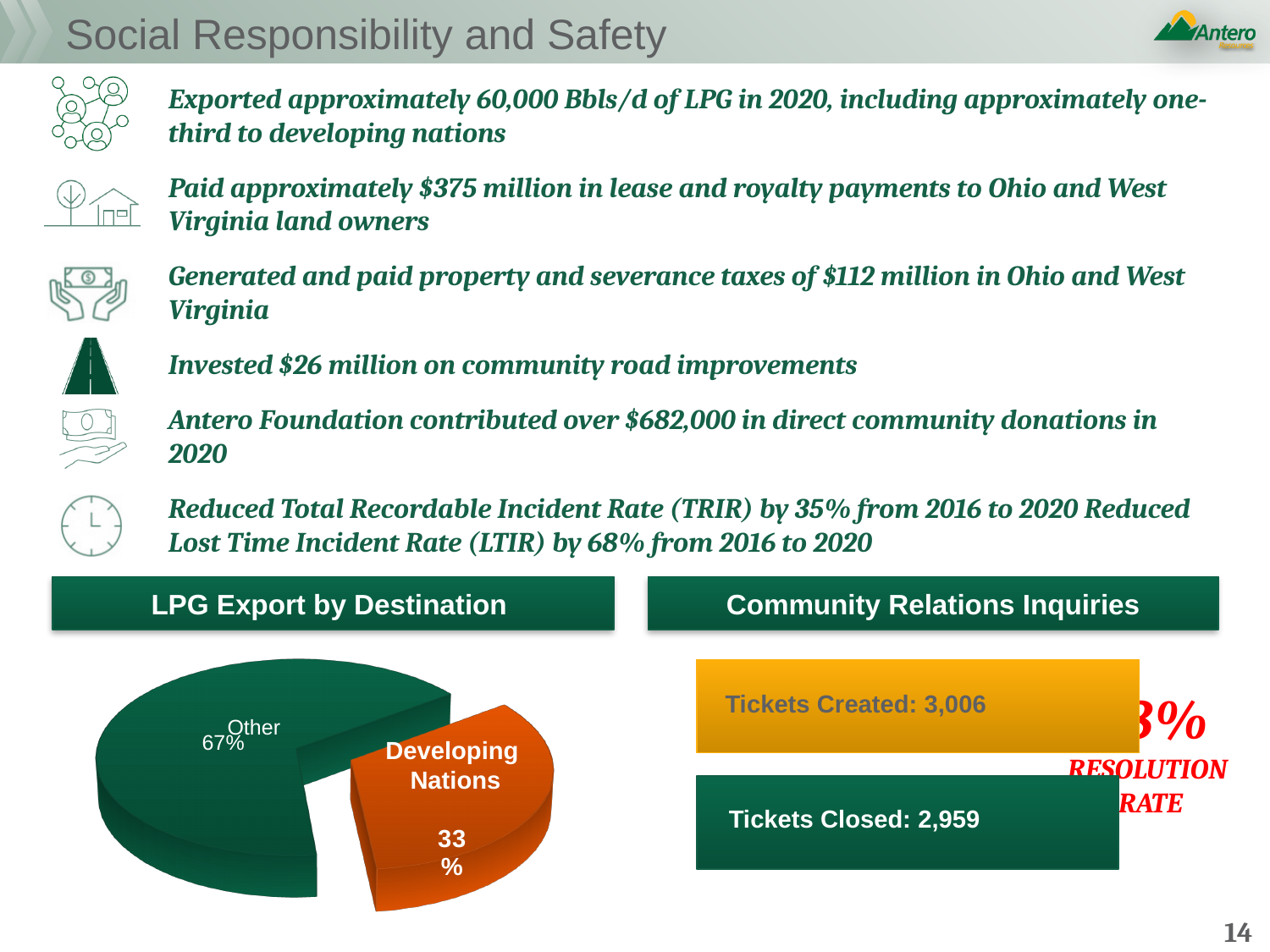
In the 'LPG Export by Destination' chart, which destination category has the smallest share? Developing Nations In the 'LPG Export by Destination' chart, what colour is the Developing Nations slice? orange In the 'LPG Export by Destination' chart, what share of LPG exports goes to Developing Nations? 33% In the 'Community Relations Inquiries' chart, how many tickets were created? 3,006 In the 'LPG Export by Destination' chart, which slice is larger: Other or Developing Nations? Other In the 'LPG Export by Destination' chart, how many slices does the pie have? 2 In the 'LPG Export by Destination' chart, which destination category has the largest share? Other In the 'LPG Export by Destination' chart, what is the difference in percentage points between the Other share and the Developing Nations share? 34 percentage points In the 'Community Relations Inquiries' chart, what is the difference between tickets created and tickets closed? 47 In the 'LPG Export by Destination' chart, what share of LPG exports goes to Other destinations? 67% What kind of chart is the 'LPG Export by Destination' chart? pie chart In the 'Community Relations Inquiries' chart, how many tickets were closed? 2,959